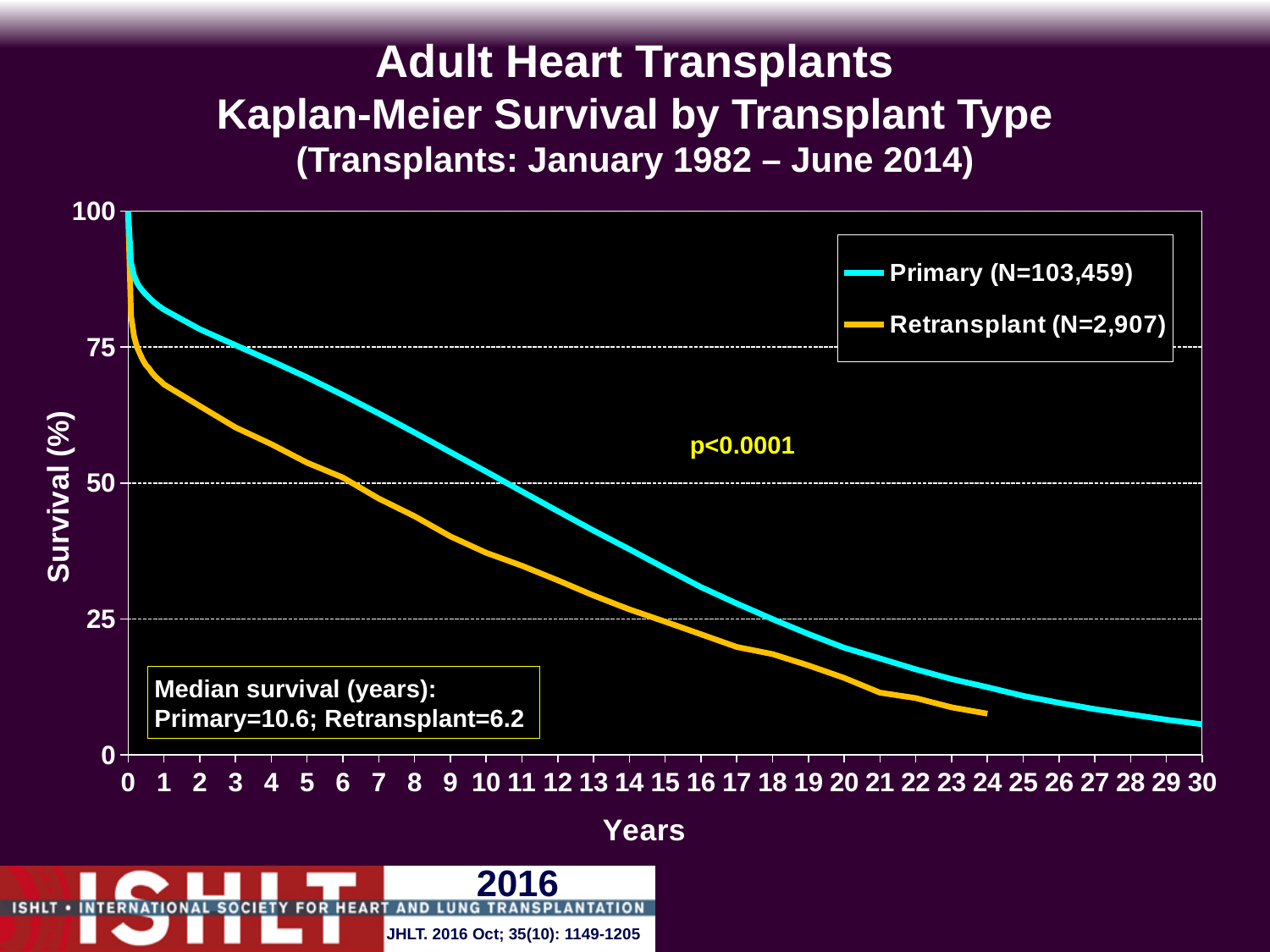
What kind of chart is shown on the slide? Line chart What is the N for the Retransplant series in the legend? 2,907 What p-value is shown on the chart? p<0.0001 Do the survival curves rise or fall as years increase? Fall What is the difference in median survival (years) between Primary and Retransplant? 4.4 What is the median survival in years for Primary transplants? 10.6 Which transplant type has the higher median survival? Primary How many series does the legend list? 2 Is the Retransplant survival value at year 10 greater or less than 50? less Is the Primary survival value at year 5 greater or less than 50? greater What is the median survival in years for Retransplants? 6.2 What is the N for the Primary series in the legend? 103,459